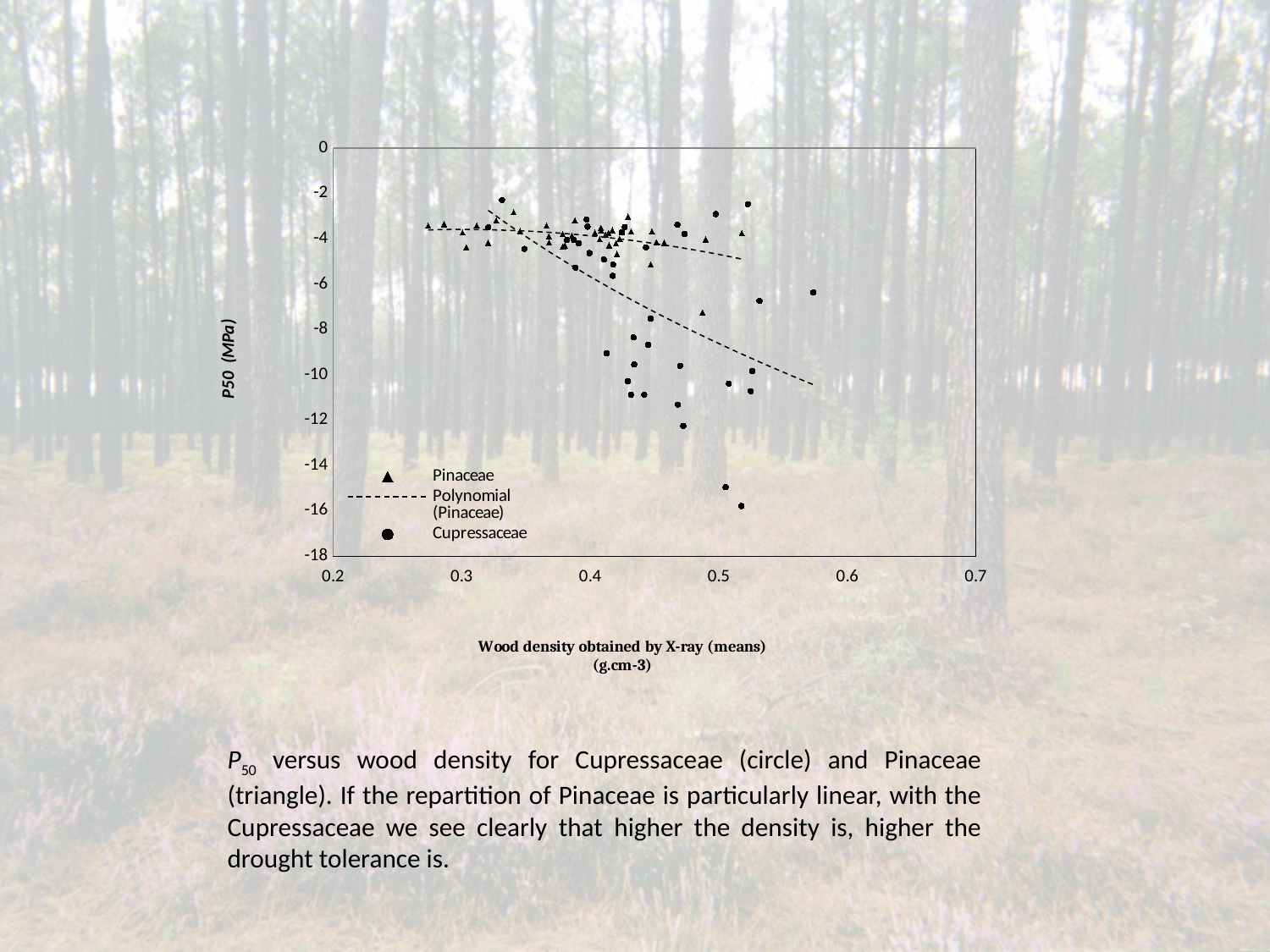
Is the lowest Cupressaceae point greater or less than -14? less What kind of chart is shown on the slide? scatter chart What is the title of the x axis? Wood density obtained by X-ray (means) (g.cm-3) How many entries does the chart legend list? 3 Are all the Pinaceae points greater or less than -10? greater What is the title of the y axis? P50 (MPa) Which series reaches lower P50 values, Pinaceae or Cupressaceae? Cupressaceae Does the steeper dashed trendline through the Cupressaceae points rise or fall as wood density increases? fall Is the highest Cupressaceae point greater or less than -4? greater